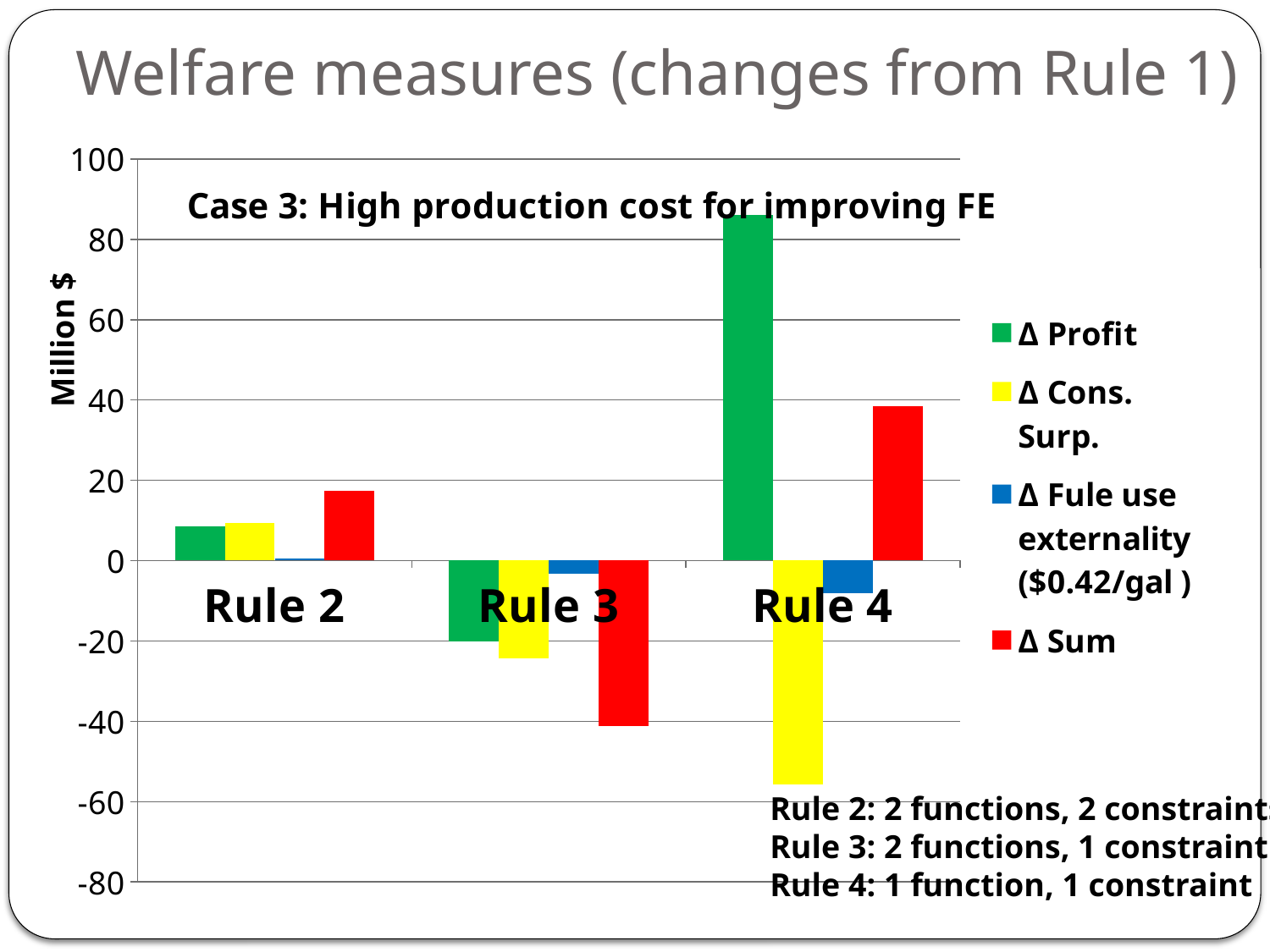
For which rule is Δ Cons. Surp. the lowest? Rule 4 How many rule categories are shown on the x axis of the chart? 3 Is the value of Δ Sum for Rule 4 greater or less than 20? greater Is the value of Δ Profit for Rule 4 greater or less than 80? greater For which rule is Δ Profit the highest? Rule 4 Is the value of Δ Cons. Surp. for Rule 4 greater or less than -40? less How many series does the chart's legend list? 4 Which is larger, Δ Profit for Rule 2 or Δ Profit for Rule 3? Rule 2 What kind of chart is shown on the slide? bar chart Which is larger, Δ Sum for Rule 2 or Δ Sum for Rule 4? Rule 4 What is the label on the vertical axis of the chart? Million $